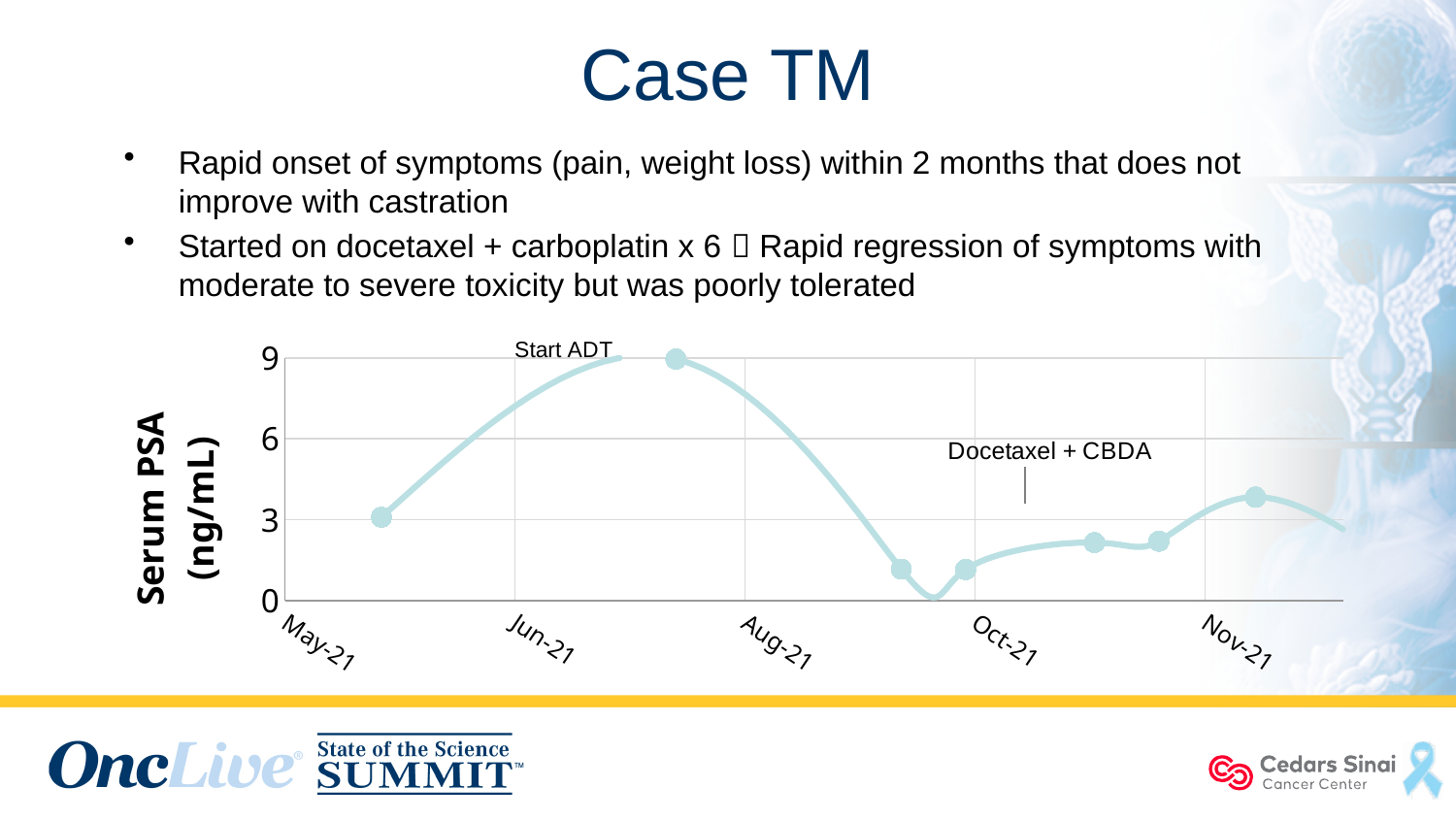
How many month labels are shown on the x axis of the chart? 5 How many data point markers are plotted on the line? 7 Is the value of the last plotted point, near Nov-21, greater or less than 3? greater Which of the two values is larger: the point at May-21 or the peak marked 'Start ADT'? the peak marked 'Start ADT' Is the lowest plotted value on the chart greater or less than 3? less What kind of chart is shown on the slide? line chart Does the serum PSA rise or fall between the peak marked 'Start ADT' and the next plotted point? fall Does the serum PSA rise or fall from May-21 to the peak marked 'Start ADT'? rise Is the value for May-21 greater or less than 6? less What is the title of the vertical axis of the chart? Serum PSA (ng/mL) What annotation is placed near the peak of the line in the chart? Start ADT